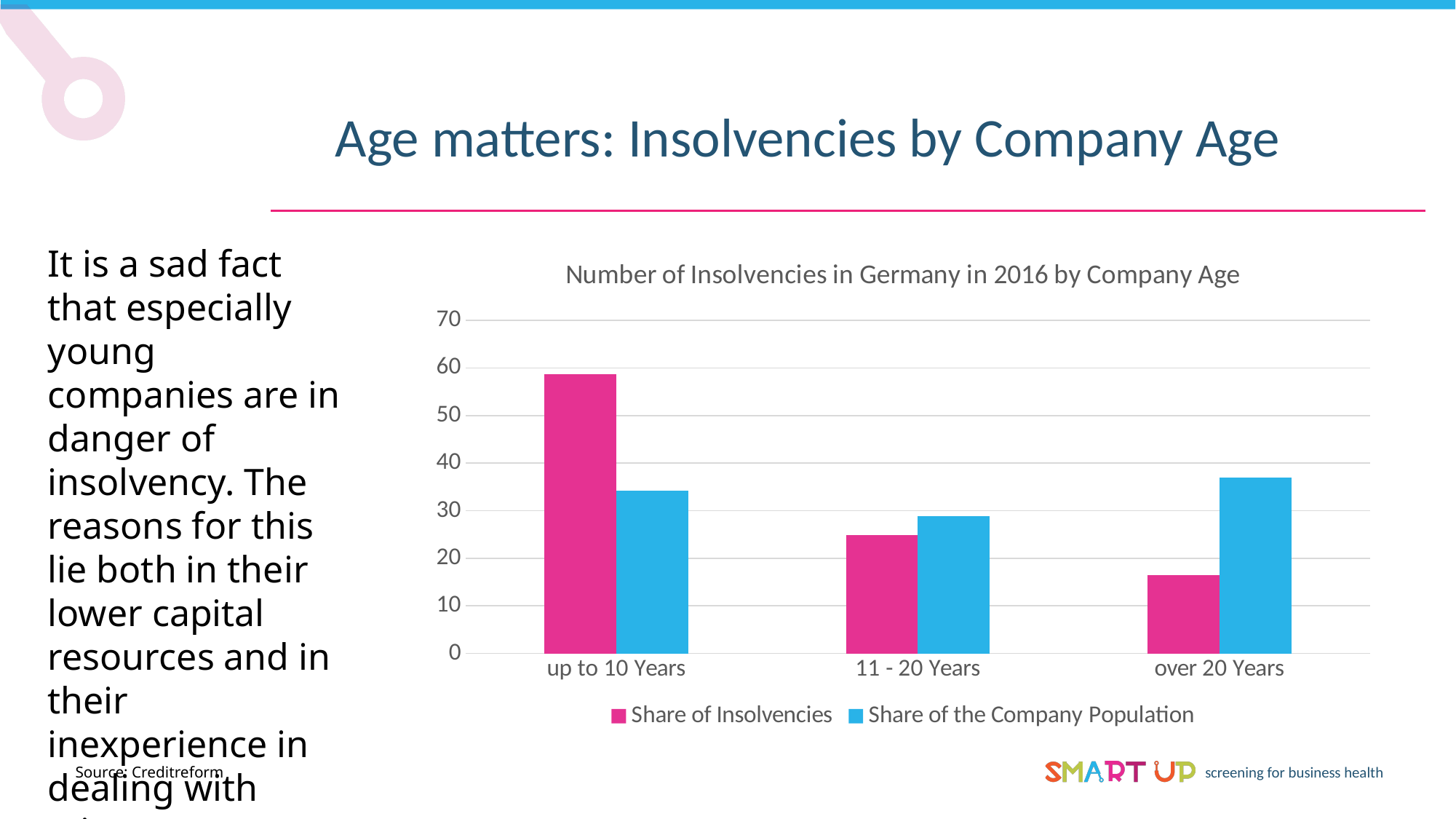
What kind of chart is shown on the slide? bar chart Which company age category has the lowest Share of Insolvencies? over 20 Years How many series does the legend list? 2 How many company age categories are shown on the x axis? 3 Is the Share of Insolvencies for over 20 Years greater or less than 20? less Which series is shown in pink? Share of Insolvencies Which company age category has the lowest Share of the Company Population? 11 - 20 Years Is the Share of Insolvencies for up to 10 Years greater or less than 50? greater What is the title of the chart? Number of Insolvencies in Germany in 2016 by Company Age Which company age category has the highest Share of Insolvencies? up to 10 Years Does the Share of Insolvencies rise or fall as company age increases along the x axis? fall For over 20 Years, which is larger: Share of Insolvencies or Share of the Company Population? Share of the Company Population